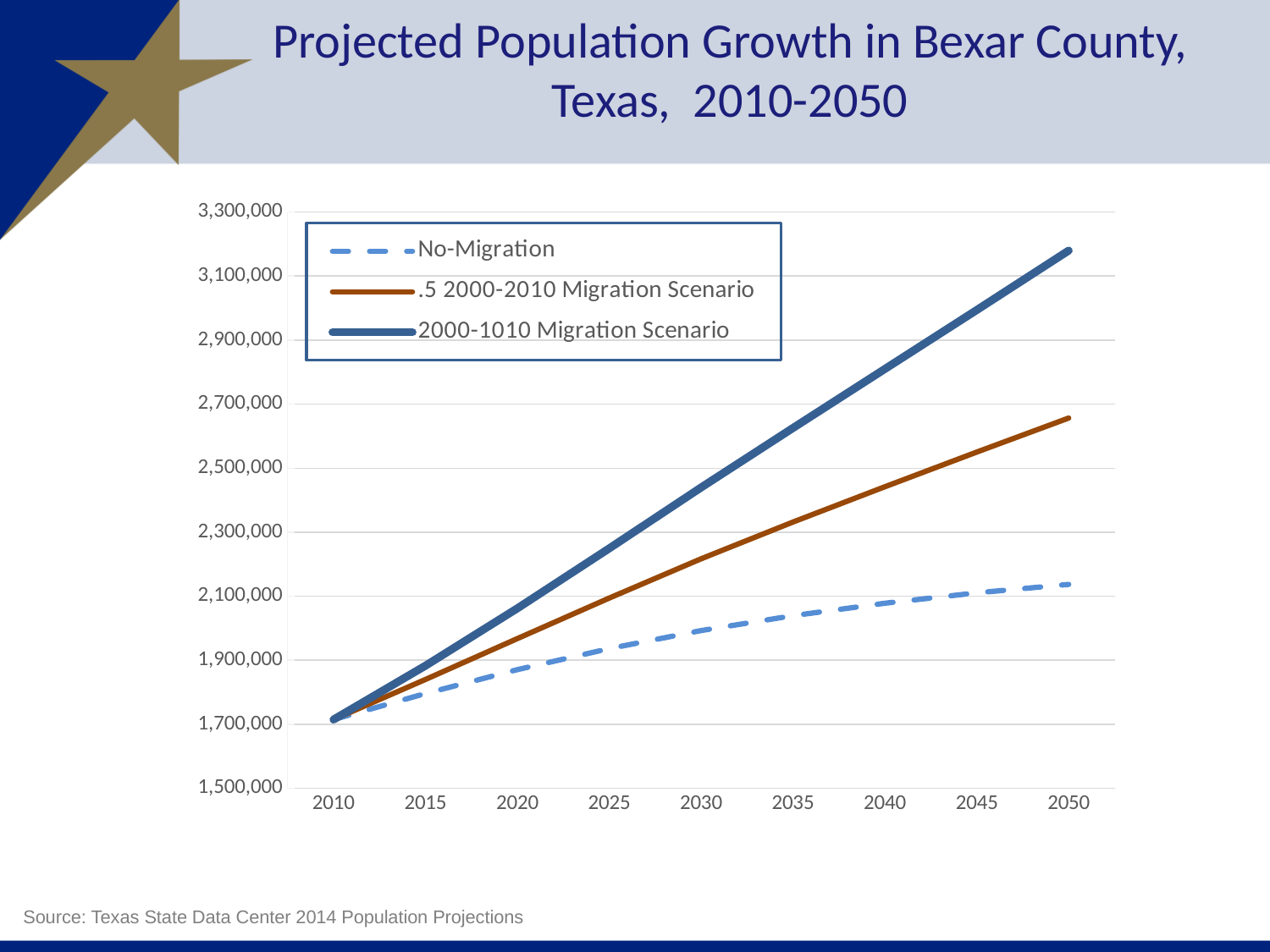
Is the value for the No-Migration series in 2030 greater or less than 2,100,000? less Which series has the lowest value in 2050? No-Migration How many year labels are shown along the x axis? 9 Which series is drawn with a dashed line? No-Migration Which series has the highest value in 2050? 2000-1010 Migration Scenario Is the value for the 2000-1010 Migration Scenario in 2050 greater or less than 3,100,000? greater In 2040, which is larger: the .5 2000-2010 Migration Scenario or the No-Migration series? .5 2000-2010 Migration Scenario Is the value for the .5 2000-2010 Migration Scenario in 2050 greater or less than 2,700,000? less Do the values for the No-Migration series rise or fall from 2010 to 2050? rise How many series does the legend list? 3 What is the title of the chart? Projected Population Growth in Bexar County, Texas, 2010-2050 What kind of chart is shown on the slide? line chart